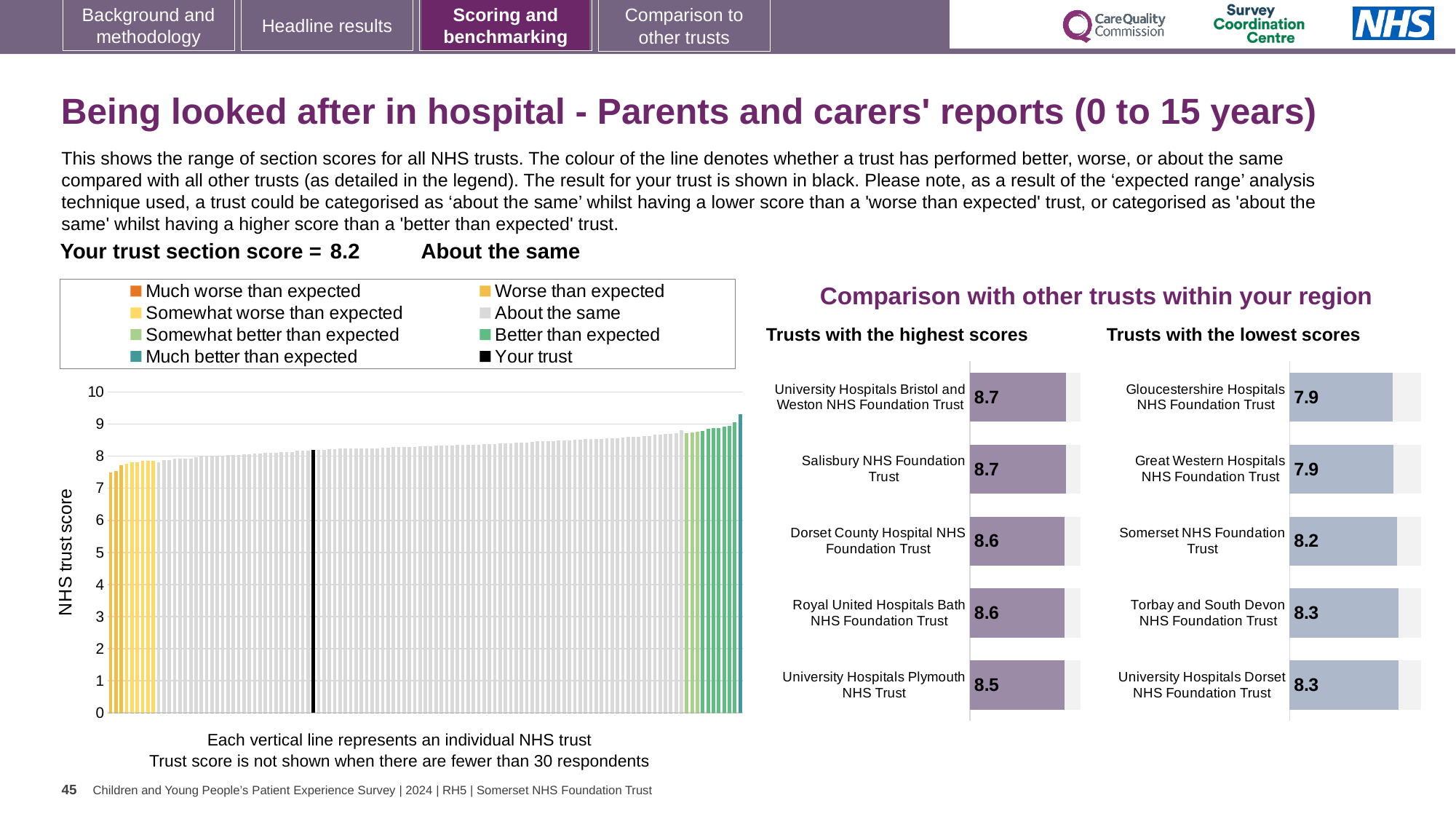
On the main chart on the left, is the value of the highest bar greater or less than 8? greater On the 'Trusts with the lowest scores' chart, which is larger: the score for Torbay and South Devon NHS Foundation Trust or the score for Gloucestershire Hospitals NHS Foundation Trust? Torbay and South Devon NHS Foundation Trust On the 'Trusts with the highest scores' chart, what is the difference between the scores of University Hospitals Bristol and Weston NHS Foundation Trust and University Hospitals Plymouth NHS Trust? 0.2 On the main chart on the left, what is the label of the y axis? NHS trust score On the 'Trusts with the highest scores' chart, what is the score for Dorset County Hospital NHS Foundation Trust? 8.6 On the 'Trusts with the lowest scores' chart, what is the difference between the scores of Somerset NHS Foundation Trust and Great Western Hospitals NHS Foundation Trust? 0.3 On the 'Trusts with the highest scores' chart, how many trusts are shown? 5 On the 'Trusts with the lowest scores' chart, what is the score for Somerset NHS Foundation Trust? 8.2 On the main chart on the left, how many entries does the legend list? 8 On the main chart on the left, is the value of the lowest bar greater or less than 8? less On the main chart on the left, what kind of chart is used to show the NHS trust scores? bar chart On the 'Trusts with the highest scores' chart, which trust has the lowest score? University Hospitals Plymouth NHS Trust